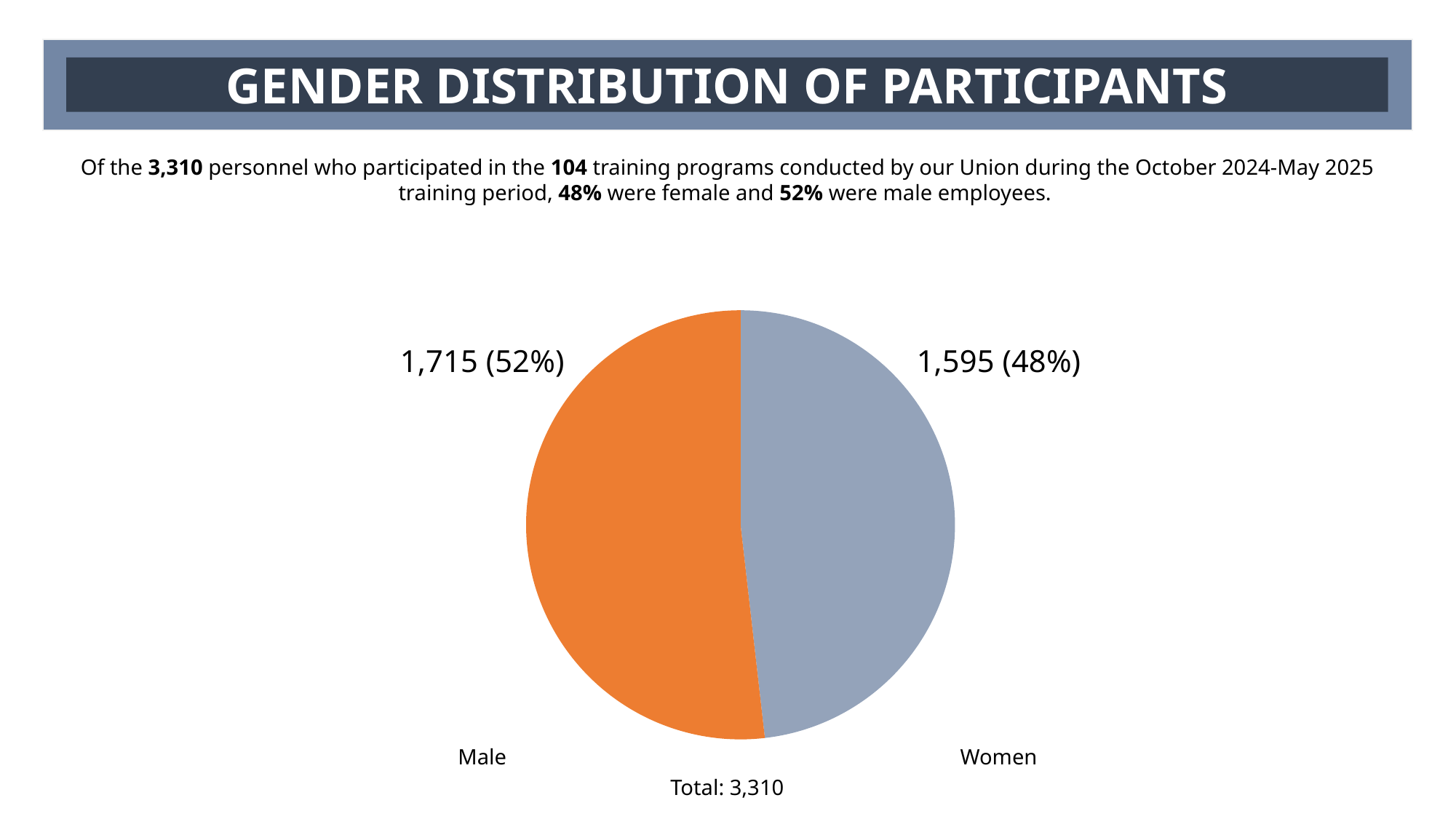
How many slices does the pie chart have? 2 What share of participants were male? 52% Which category has the smallest slice? Women What colour is the Male slice? orange What kind of chart is shown on the slide? pie chart How many participants were male? 1,715 What is the title of the slide? GENDER DISTRIBUTION OF PARTICIPANTS What share of participants were women? 48% What is the total number of participants shown on the chart? 3,310 How many participants were women? 1,595 Which group has the larger slice, Male or Women? Male What is the difference between the number of male and women participants? 120